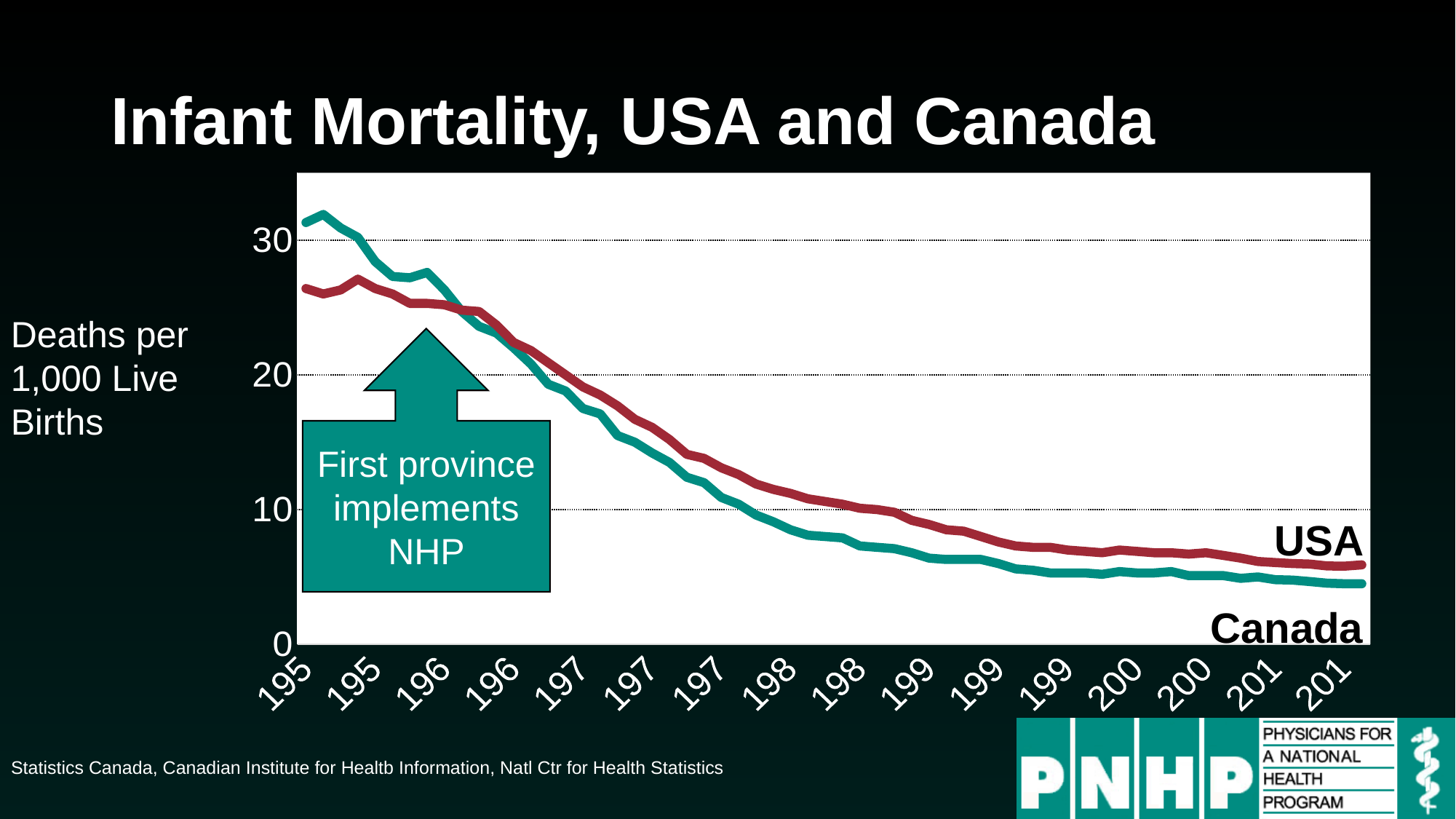
What kind of chart is shown on the slide? line chart Is the value for Canada at the start of the series greater or less than 30? greater Which two countries are plotted on the chart? USA and Canada Is the value for the USA at the end of the series greater or less than 10? less Do the infant mortality values for the USA rise or fall over time along the x axis? fall At the right-hand end of the chart, which country has the higher infant mortality, USA or Canada? USA At the left-hand start of the chart, which country has the higher infant mortality, USA or Canada? Canada What is the title of the chart? Infant Mortality, USA and Canada How many series are plotted on the chart? 2 Is the value for Canada at the end of the series greater or less than 10? less Do the infant mortality values for Canada rise or fall over time along the x axis? fall